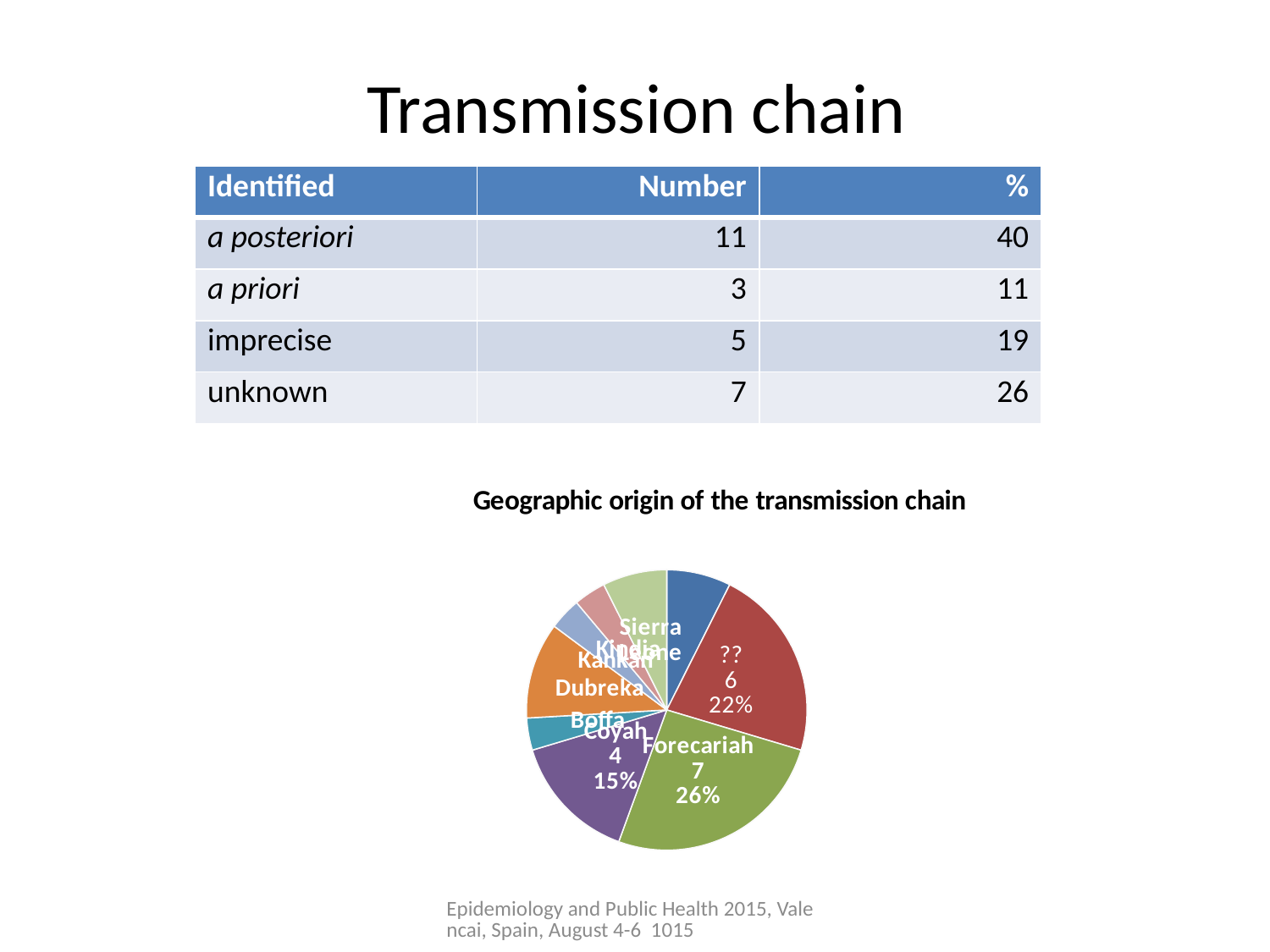
In the pie chart, how many transmission chains are in the slice labelled "??"? 6 In the pie chart, what share of the transmission chains originate from Coyah? 15% What is the title of the pie chart? Geographic origin of the transmission chain In the pie chart, what share of the transmission chains originate from Forecariah? 26% In the pie chart, how many transmission chains originate from Forecariah? 7 How many slices does the pie chart have? 9 What kind of chart is shown on the slide? pie chart In the pie chart, how many more transmission chains does Forecariah have than Coyah? 3 Which geographic origin has the largest slice in the pie chart? Forecariah In the pie chart, how many transmission chains originate from Coyah? 4 In the pie chart, which has more transmission chains, Forecariah or Coyah? Forecariah In the pie chart, what share does the slice labelled "??" represent? 22%